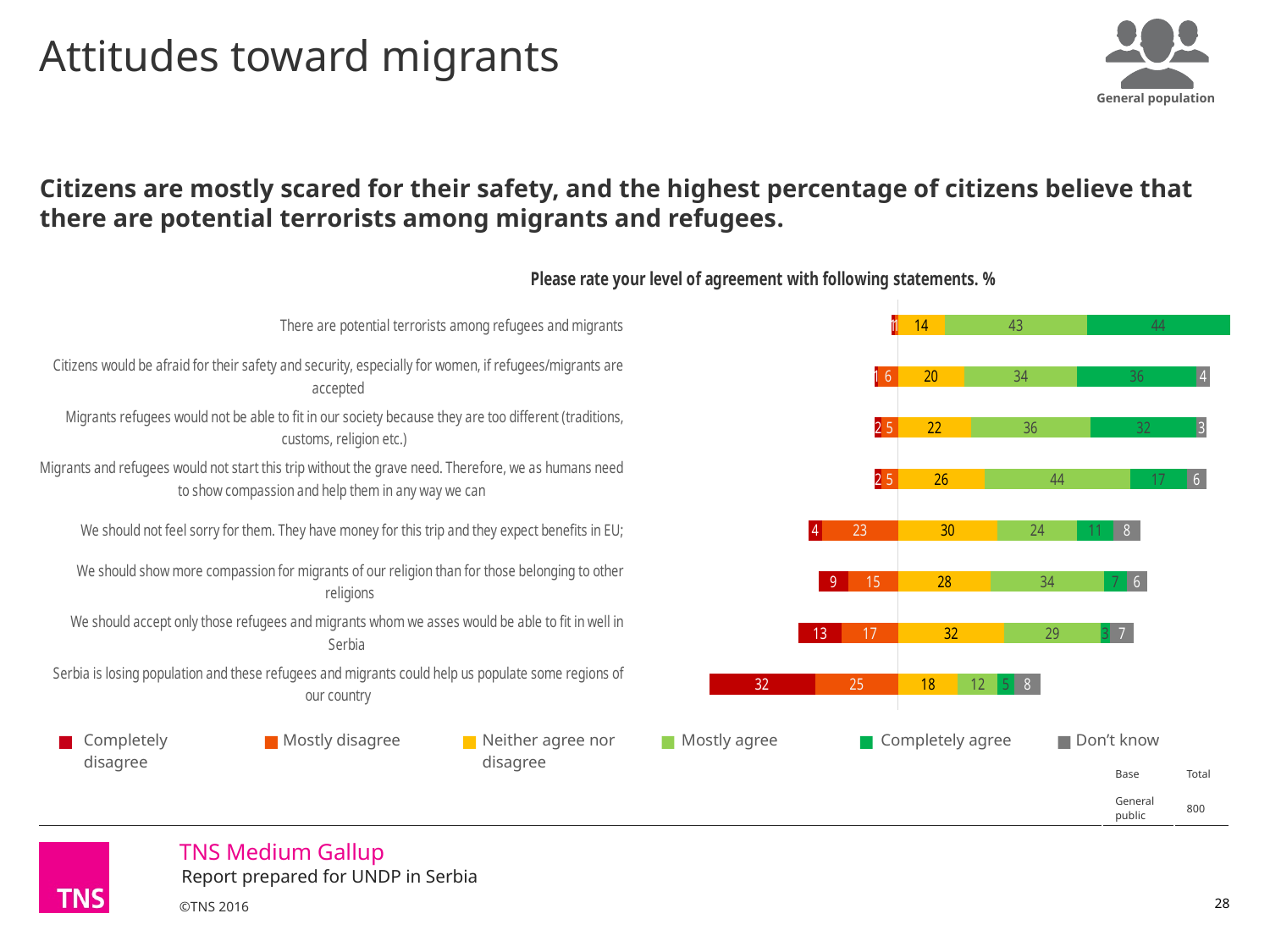
Which statement has the lowest 'Mostly agree' value? Serbia is losing population and these refugees and migrants could help us populate some regions of our country How many series does the legend list? 6 What is the title of the chart? Please rate your level of agreement with following statements. % What is the 'Completely disagree' value for 'Serbia is losing population and these refugees and migrants could help us populate some regions of our country'? 32 What is the 'Mostly agree' value for 'Migrants and refugees would not start this trip without the grave need. Therefore, we as humans need to show compassion and help them in any way we can'? 44 What kind of chart is shown on the slide? Stacked bar chart Which is larger: the 'Mostly disagree' value for 'We should not feel sorry for them. They have money for this trip and they expect benefits in EU;' or for 'We should show more compassion for migrants of our religion than for those belonging to other religions'? We should not feel sorry for them. They have money for this trip and they expect benefits in EU; What is the 'Neither agree nor disagree' value for 'We should accept only those refugees and migrants whom we asses would be able to fit in well in Serbia'? 32 Which statement has the highest 'Completely agree' value? There are potential terrorists among refugees and migrants What is the difference between the 'Completely agree' values for 'Citizens would be afraid for their safety and security, especially for women, if refugees/migrants are accepted' (36) and 'We should not feel sorry for them. They have money for this trip and they expect benefits in EU;' (11)? 25 What is the 'Completely agree' value for 'There are potential terrorists among refugees and migrants'? 44 How many statements are plotted in the chart? 8